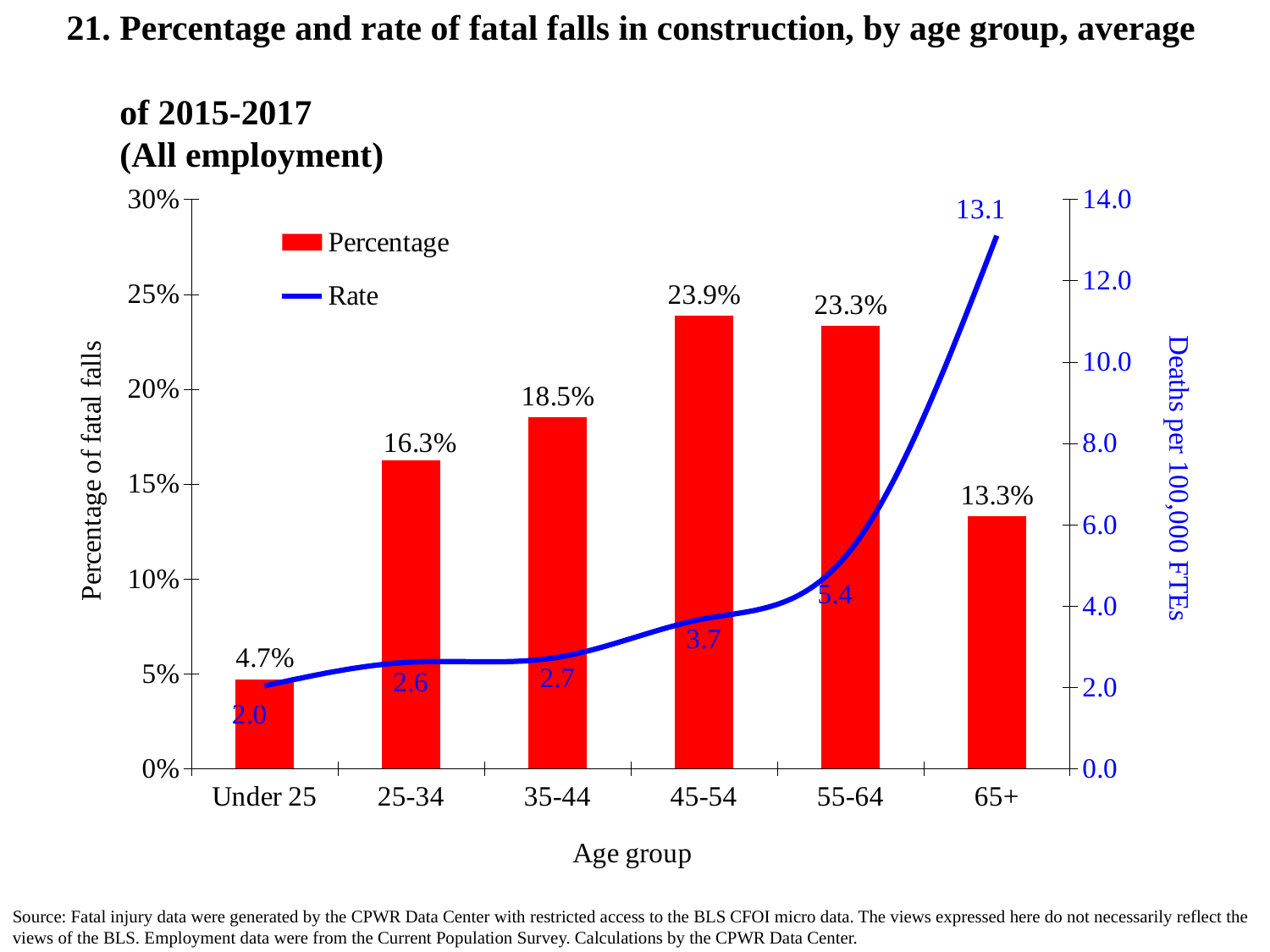
Which age group has the highest percentage of fatal falls? 45-54 How many age groups are shown on the x axis? 6 Which has a higher percentage of fatal falls, the 25-34 or the 35-44 age group? 35-44 What is the percentage of fatal falls for the 45-54 age group? 23.9% Does the rate of fatal falls rise or fall as age group increases along the x axis? rise How many series does the legend list? 2 What is the difference in rate between the 65+ and 55-64 age groups? 7.7 What is the rate of fatal falls (deaths per 100,000 FTEs) for the 65+ age group? 13.1 What is the difference in percentage of fatal falls between the 45-54 and 55-64 age groups? 0.6% What is the label of the right-hand vertical axis? Deaths per 100,000 FTEs Which age group has the lowest rate of fatal falls? Under 25 What is the percentage of fatal falls for the Under 25 age group? 4.7%